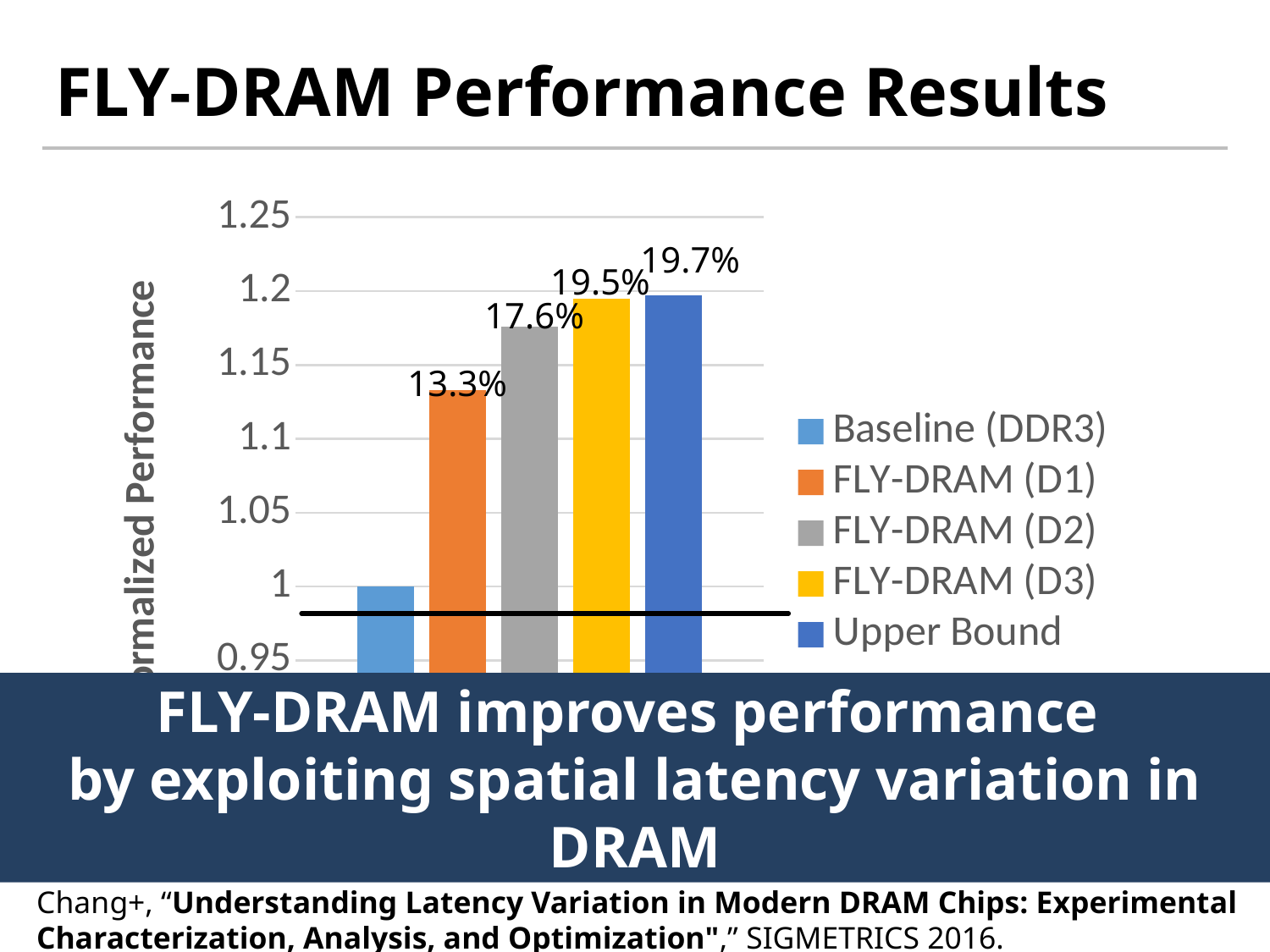
Is the normalized performance for FLY-DRAM (D1) greater or less than 1.1? greater What kind of chart is shown on the slide? bar chart How many series does the legend list? 5 What percentage label is shown above the Upper Bound bar? 19.7% What is the normalized performance of the Baseline (DDR3) bar? 1 What percentage label is shown above the FLY-DRAM (D3) bar? 19.5% What is the difference between the percentage labels of Upper Bound and FLY-DRAM (D1)? 6.4% What percentage label is shown above the FLY-DRAM (D2) bar? 17.6% Which bar is taller, FLY-DRAM (D1) or FLY-DRAM (D2)? FLY-DRAM (D2) Which series has the lowest normalized performance? Baseline (DDR3) Do the bars rise or fall from left to right across the chart? rise What percentage label is shown above the FLY-DRAM (D1) bar? 13.3%